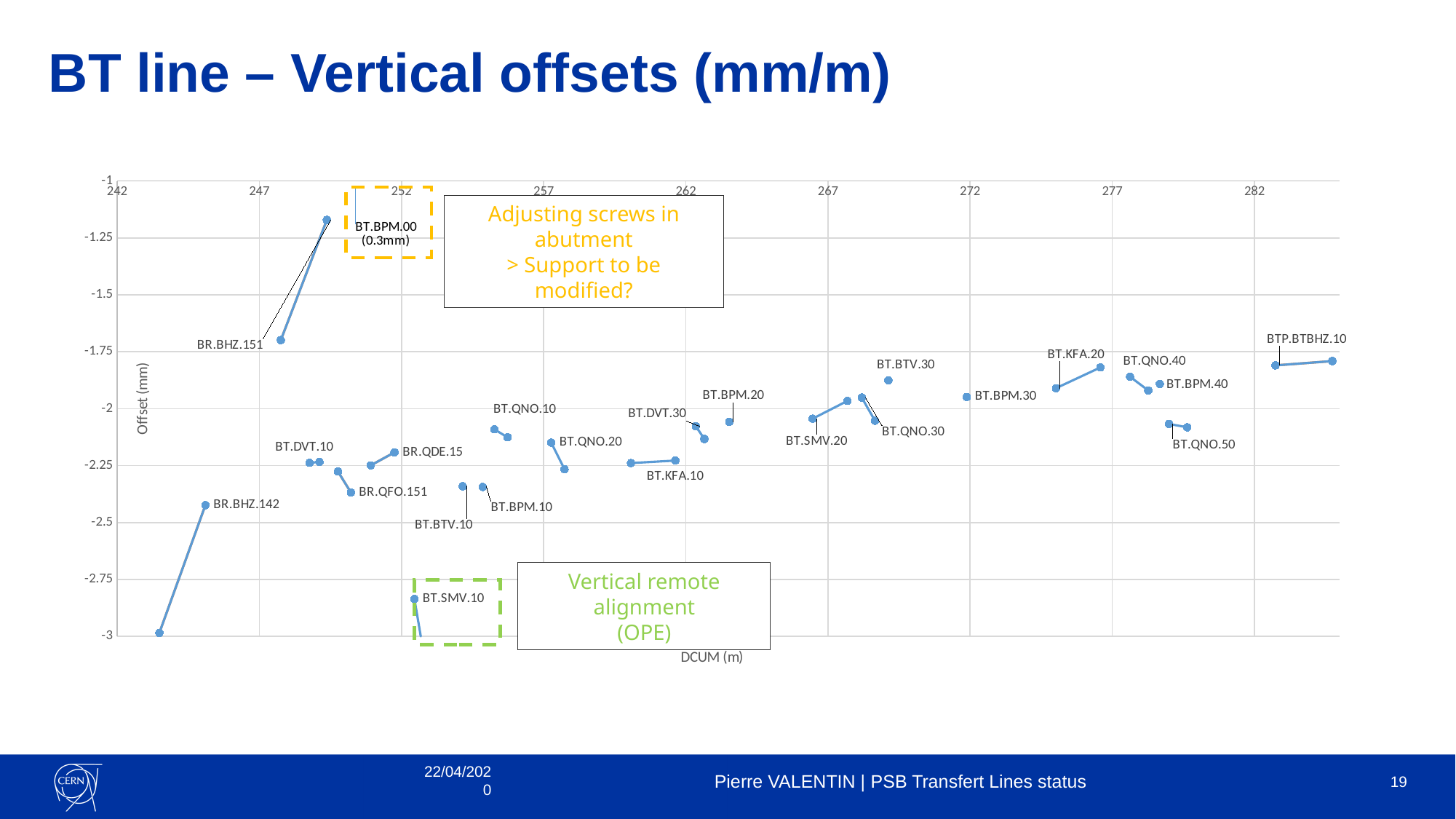
What is the label of the horizontal axis of the chart? DCUM (m) Along its segment, does the offset for BR.BHZ.142 rise or fall with increasing DCUM? rise Which has the higher offset, BT.BPM.00 or BR.BHZ.142? BT.BPM.00 What kind of chart is shown on the slide? scatter chart with line segments What is the label of the vertical axis of the chart? Offset (mm) Is the offset for BT.SMV.10 greater or less than -2.75? less Is the offset for BT.QNO.50 greater or less than -2? less Is the offset for BT.BPM.10 greater or less than -2.25? less Which has the higher offset, BTP.BTBHZ.10 or BT.QNO.50? BTP.BTBHZ.10